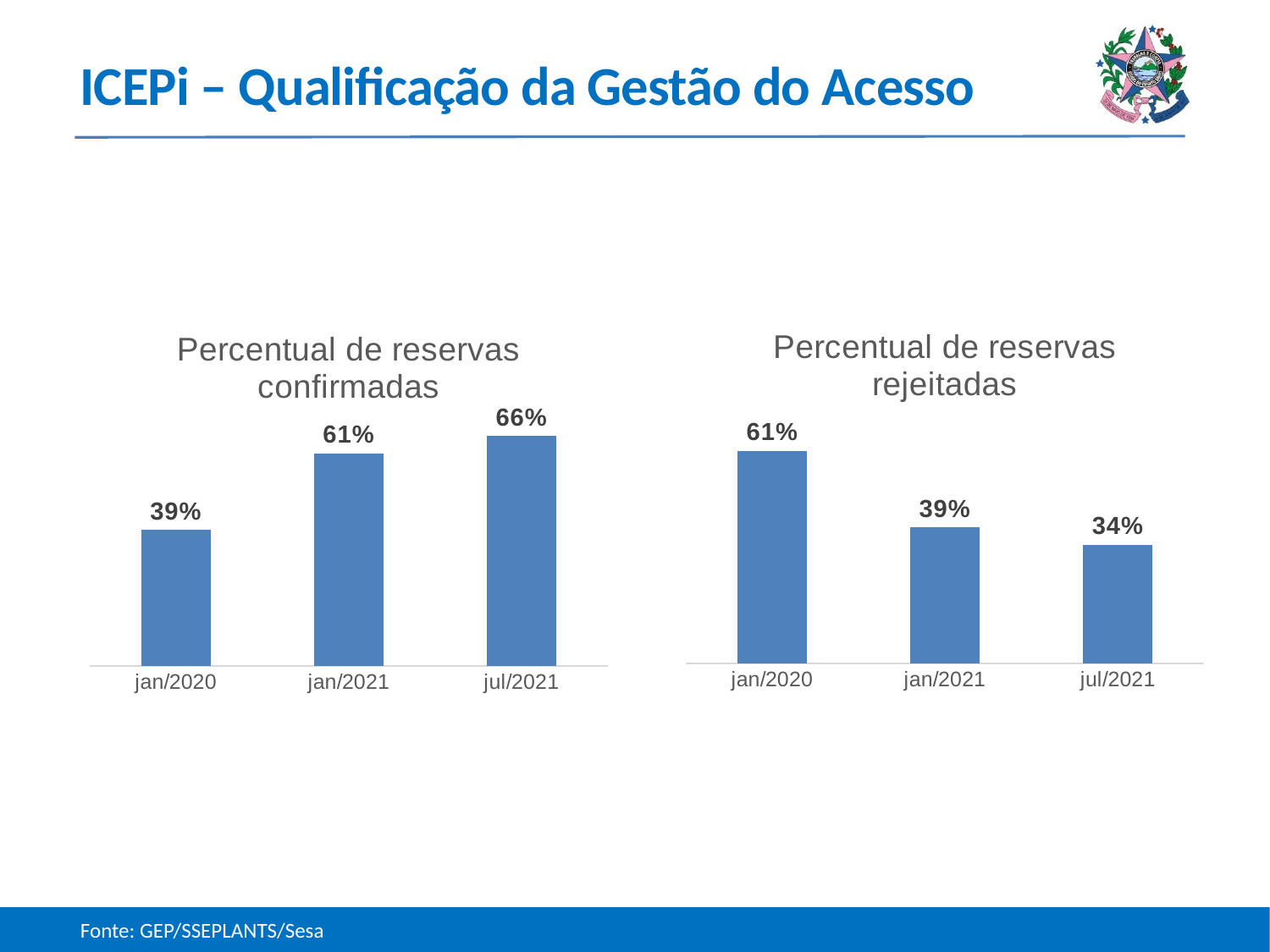
What kind of chart is the 'Percentual de reservas rejeitadas' chart? bar chart In the 'Percentual de reservas confirmadas' chart, what is the value for jul/2021? 66% In the 'Percentual de reservas rejeitadas' chart, which is larger: the value for jan/2020 or the value for jul/2021? jan/2020 In the 'Percentual de reservas confirmadas' chart, what is the difference between the jul/2021 and jan/2020 values? 27% In the 'Percentual de reservas confirmadas' chart, what is the value for jan/2020? 39% In the 'Percentual de reservas rejeitadas' chart, do the values rise or fall from jan/2020 to jul/2021? fall How many periods are shown on the x axis of the 'Percentual de reservas confirmadas' chart? 3 In the 'Percentual de reservas rejeitadas' chart, what is the value for jan/2021? 39% In the 'Percentual de reservas confirmadas' chart, which period has the highest value? jul/2021 In the 'Percentual de reservas rejeitadas' chart, which period has the lowest value? jul/2021 In the 'Percentual de reservas rejeitadas' chart, what is the value for jul/2021? 34% In the 'Percentual de reservas rejeitadas' chart, what is the difference between the jan/2020 and jan/2021 values? 22%